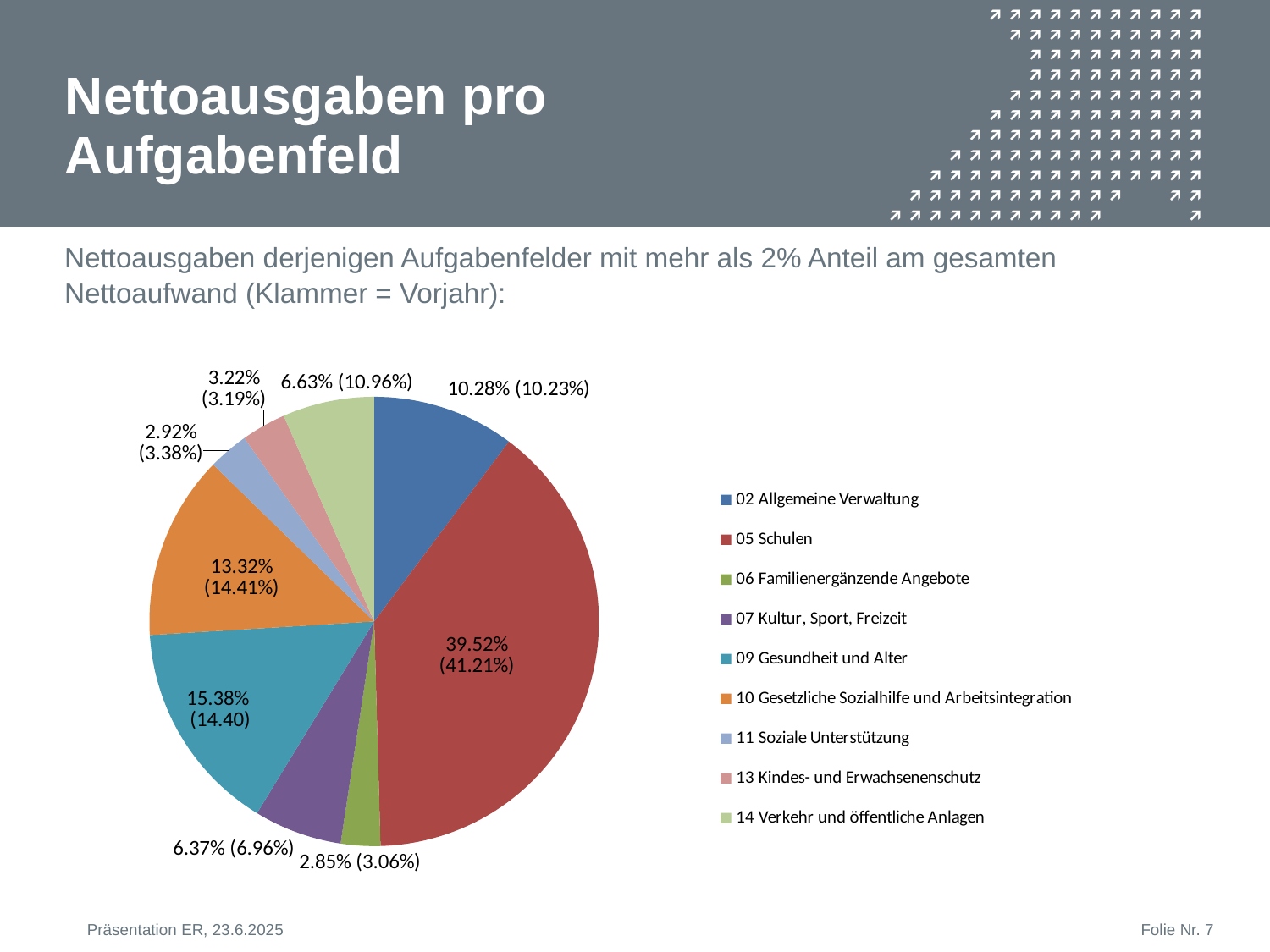
What is the prior-year share (in parentheses) shown for 14 Verkehr und öffentliche Anlagen? 10.96% What is the current-year share shown for 09 Gesundheit und Alter? 15.38% How many slices does the pie chart have? 9 Which category has the smallest slice of the pie? 06 Familienergänzende Angebote What is the current-year share shown for 02 Allgemeine Verwaltung? 10.28% What is the prior-year share (in parentheses) shown for 05 Schulen? 41.21% What is the current-year share shown for 05 Schulen? 39.52% What is the difference between the current-year shares of 09 Gesundheit und Alter and 10 Gesetzliche Sozialhilfe und Arbeitsintegration? 2.06% Which category has the largest slice of the pie? 05 Schulen What kind of chart is shown on the slide? pie chart Which has the larger current-year share: 07 Kultur, Sport, Freizeit or 14 Verkehr und öffentliche Anlagen? 14 Verkehr und öffentliche Anlagen How many entries does the legend list? 9